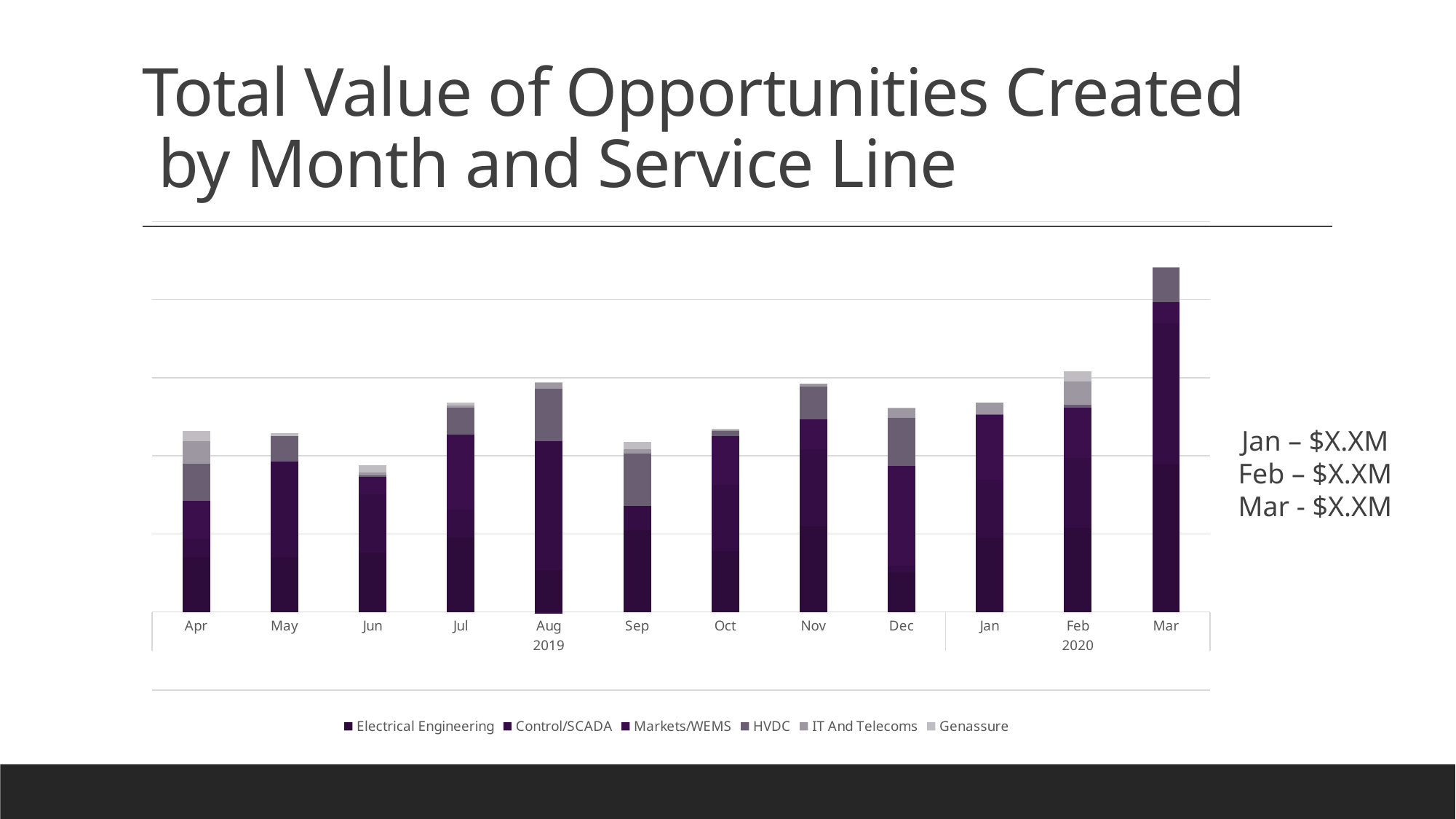
How many series does the chart's legend list? 6 Which bar is taller, Jul 2019 or Sep 2019? Jul 2019 Which month has the shortest stacked bar in the chart? Jun 2019 Which bar is taller, Nov 2019 or Oct 2019? Nov 2019 Which bar is taller, Mar 2020 or Feb 2020? Mar 2020 What is the title of the chart on the slide? Total Value of Opportunities Created by Month and Service Line Which month has the tallest stacked bar in the chart? Mar 2020 How many months are plotted along the x axis of the chart? 12 Which service line is listed first in the chart's legend? Electrical Engineering What kind of chart is shown on the slide? Stacked bar chart